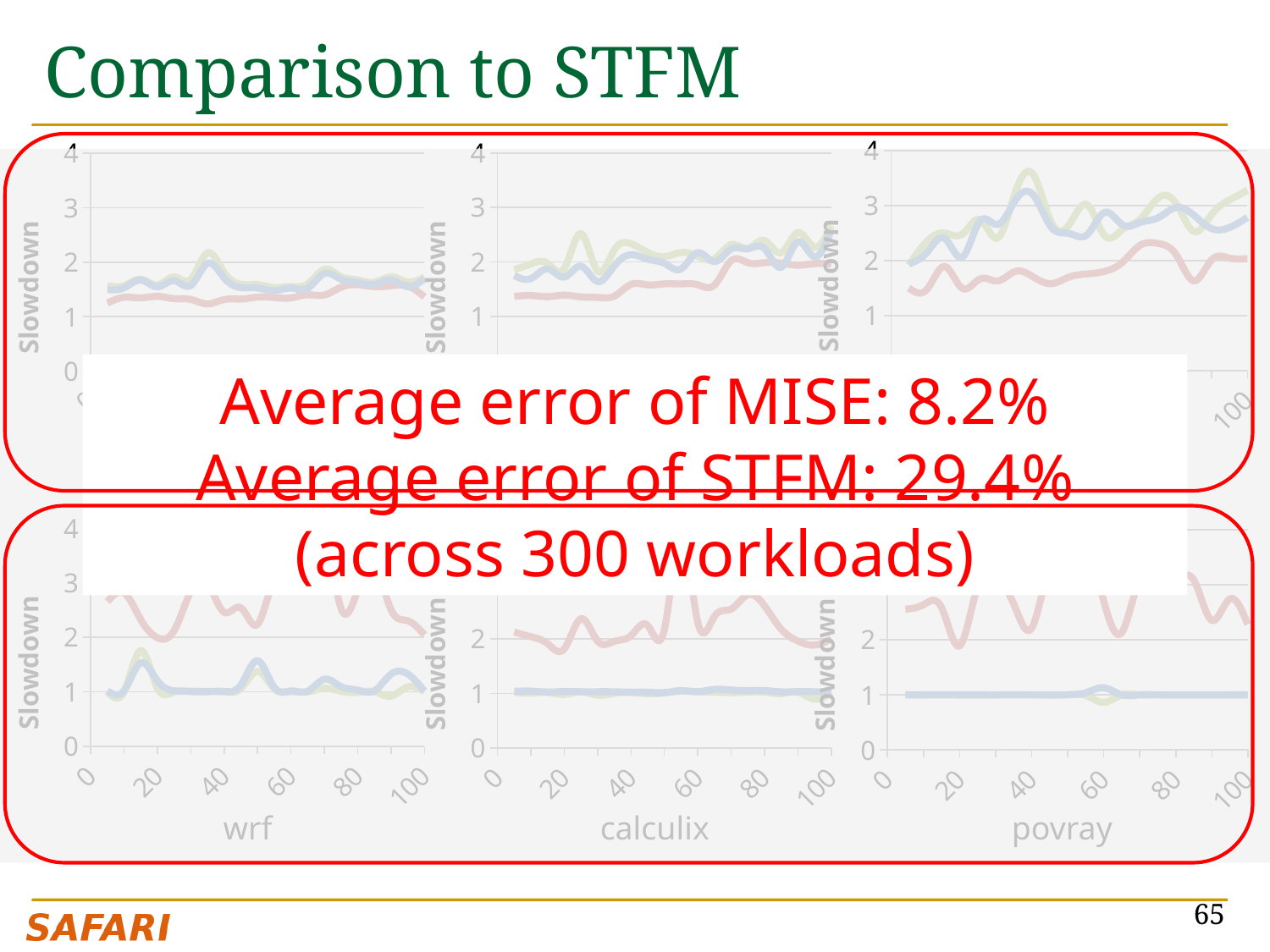
In the top-left chart, is the blue line's value at x = 80 greater or less than 2? less In the top-right chart, is the red line's value at x = 10 greater or less than 2? less In the bottom wrf chart, is the blue line's value at x = 80 greater or less than 2? less What are the labels under the three bottom-row chart panels, from left to right? wrf, calculix, povray What kind of chart is used in the bottom-left panel labelled wrf? line chart What is the y-axis label on the chart panels? Slowdown How many chart panels are shown on the slide in total? 6 What is the highest tick value shown on the y-axis of the bottom wrf chart? 4